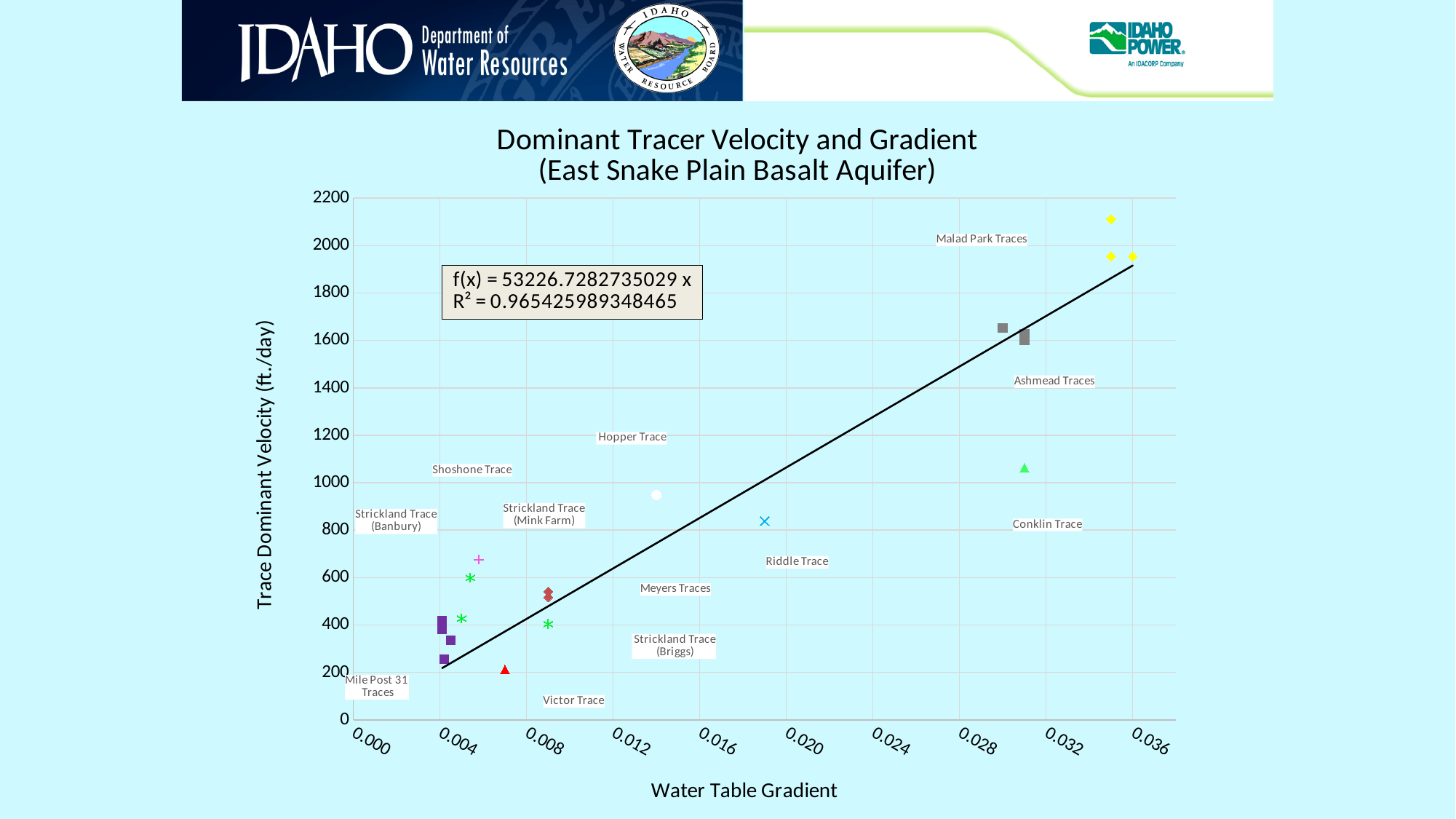
What is the label of the y axis? Trace Dominant Velocity (ft./day) Which trace group has the highest water table gradient? Malad Park Traces What is the title of the chart? Dominant Tracer Velocity and Gradient (East Snake Plain Basalt Aquifer) Is the trace dominant velocity for the Malad Park Traces greater or less than 1800 ft./day? greater What kind of chart is shown on the slide? Scatter chart Which has a higher trace dominant velocity, the Ashmead Traces or the Hopper Trace? Ashmead Traces Which has a higher trace dominant velocity, the Conklin Trace or the Riddle Trace? Conklin Trace Does trace dominant velocity generally rise or fall as water table gradient increases? Rise Which trace group has the highest trace dominant velocity? Malad Park Traces Is the trace dominant velocity for the Hopper Trace greater or less than 1000 ft./day? less Is the trace dominant velocity for the Ashmead Traces greater or less than 1400 ft./day? greater